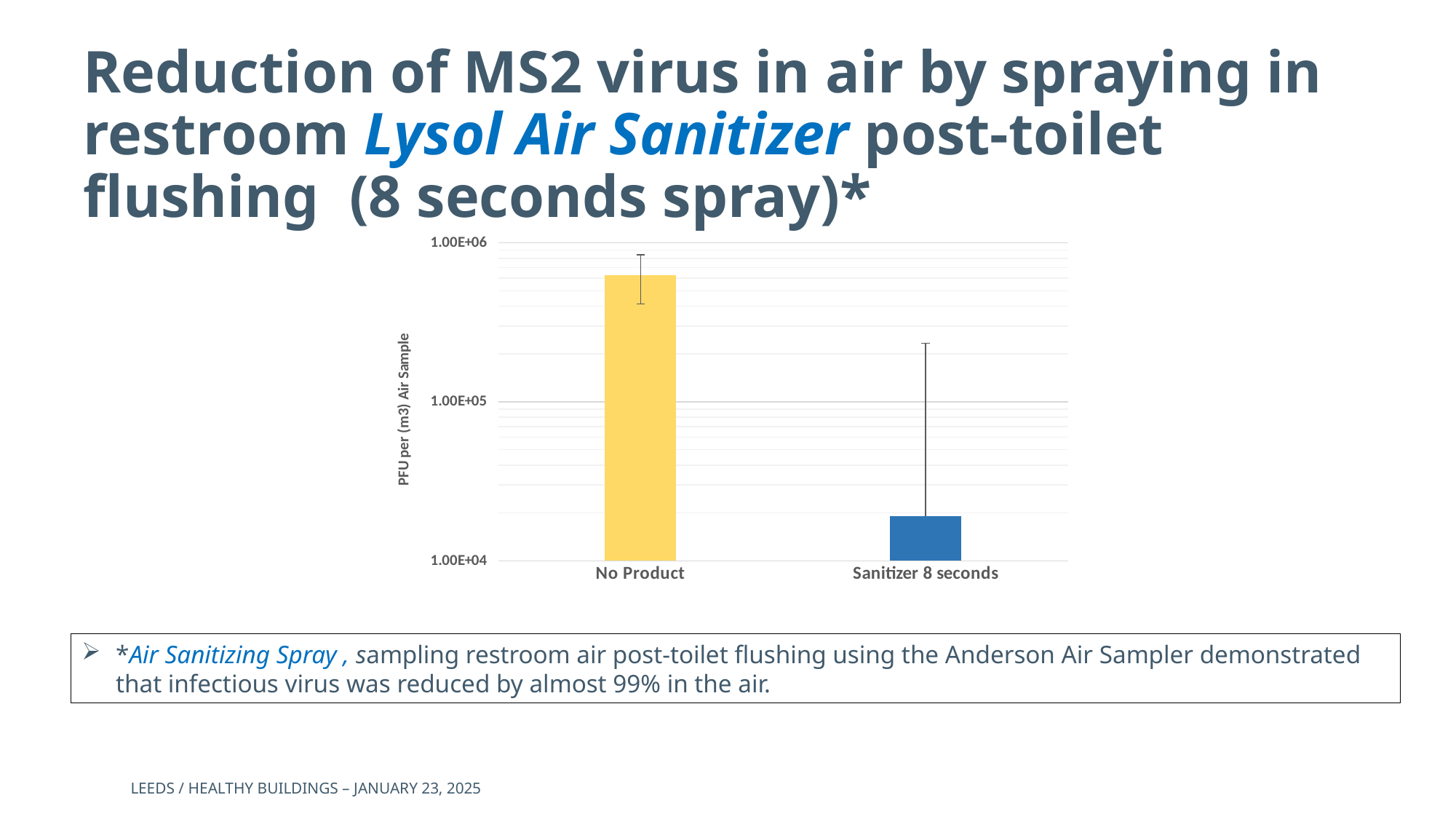
Is the value for No Product greater or less than 1.00E+05? greater Is the value for Sanitizer 8 seconds greater or less than 1.00E+05? less Is the value for No Product greater or less than 1.00E+06? less Which category has the highest value in the chart? No Product What kind of chart is shown on the slide? bar chart Which category has the lowest value in the chart? Sanitizer 8 seconds What is the label on the y axis of the chart? PFU per (m3) Air Sample What colour is the bar for Sanitizer 8 seconds? blue Which is larger, the value for No Product or the value for Sanitizer 8 seconds? No Product Do the values rise or fall from No Product to Sanitizer 8 seconds? fall How many categories are plotted on the x axis of the chart? 2